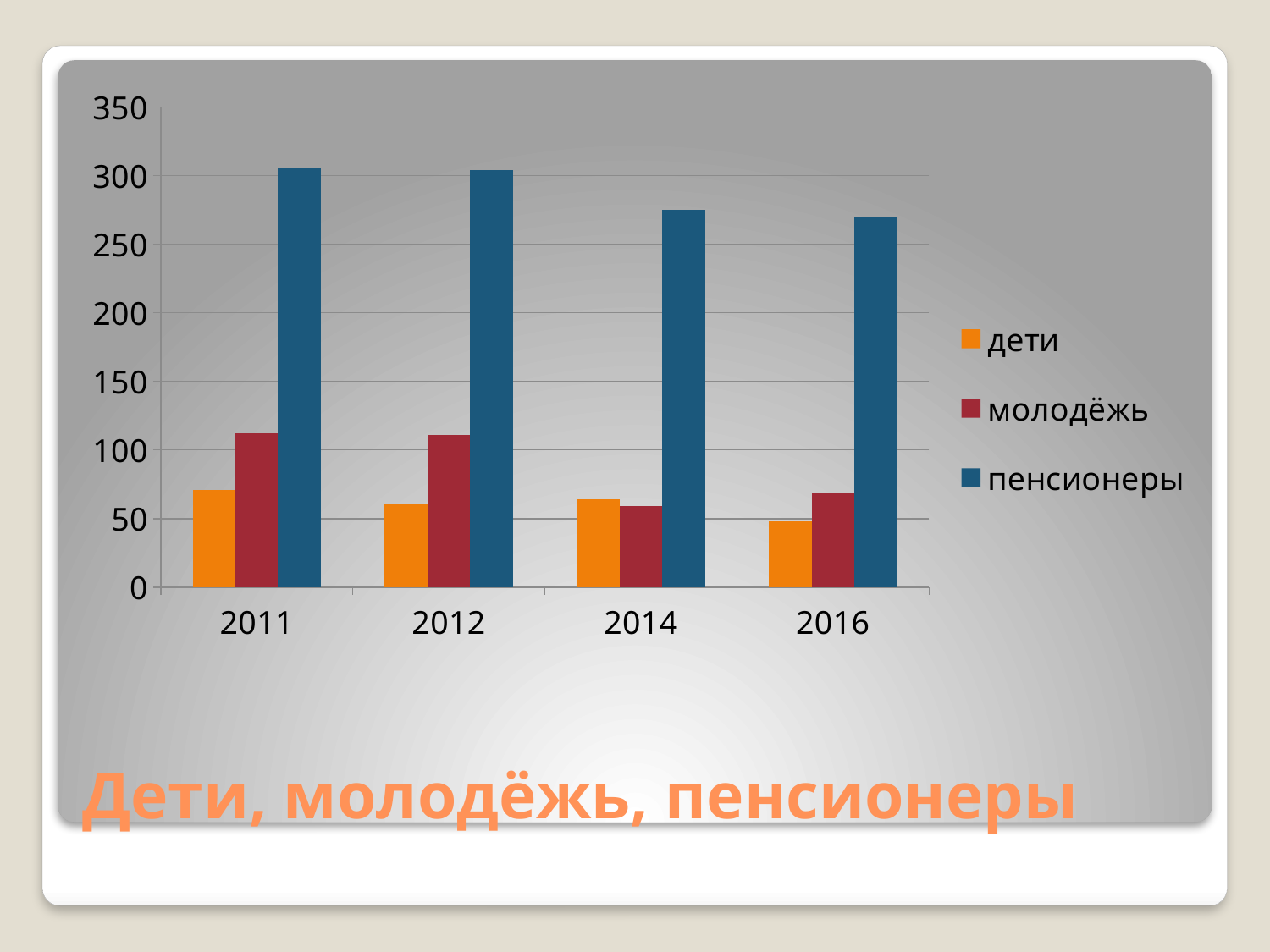
Do the values for пенсионеры rise or fall from 2011 to 2016? fall What kind of chart is shown on the slide? bar chart What is the title of the slide? Дети, молодёжь, пенсионеры In which year is the value for молодёжь the lowest? 2014 Is the value for дети in 2011 greater or less than 50? greater Is the value for пенсионеры in 2016 greater or less than 300? less In 2016, which is larger: дети or молодёжь? молодёжь How many series does the legend list? 3 How many years are shown on the x axis? 4 In which year is the value for дети the lowest? 2016 Is the value for молодёжь in 2011 greater or less than 100? greater